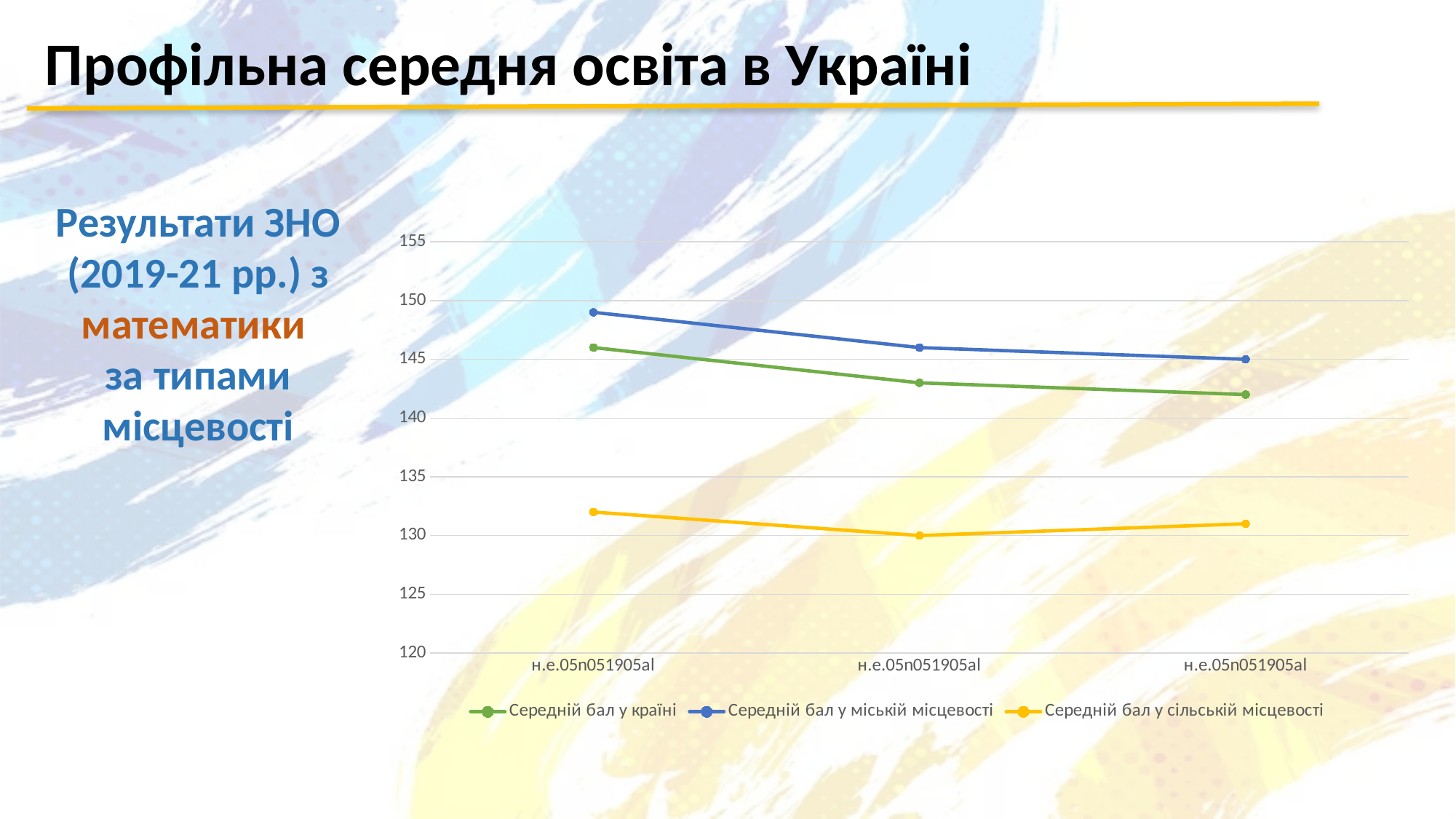
Does the line for "Середній бал у країні" rise or fall across the three points? fall How many series does the legend list? 3 Which series has the lowest values at every point? Середній бал у сільській місцевості Is the first value for "Середній бал у міській місцевості" greater or less than 145? greater How many data points does each line have? 3 Which series has the highest values at every point? Середній бал у міській місцевості Does the line for "Середній бал у міській місцевості" rise or fall from the first point to the last? fall Is the last value for "Середній бал у країні" greater or less than 140? greater At the first point, which is larger: "Середній бал у країні" or "Середній бал у сільській місцевості"? Середній бал у країні What kind of chart is shown on the slide? line chart What colour is the line for "Середній бал у сільській місцевості"? yellow Is the first value for "Середній бал у сільській місцевості" greater or less than 135? less